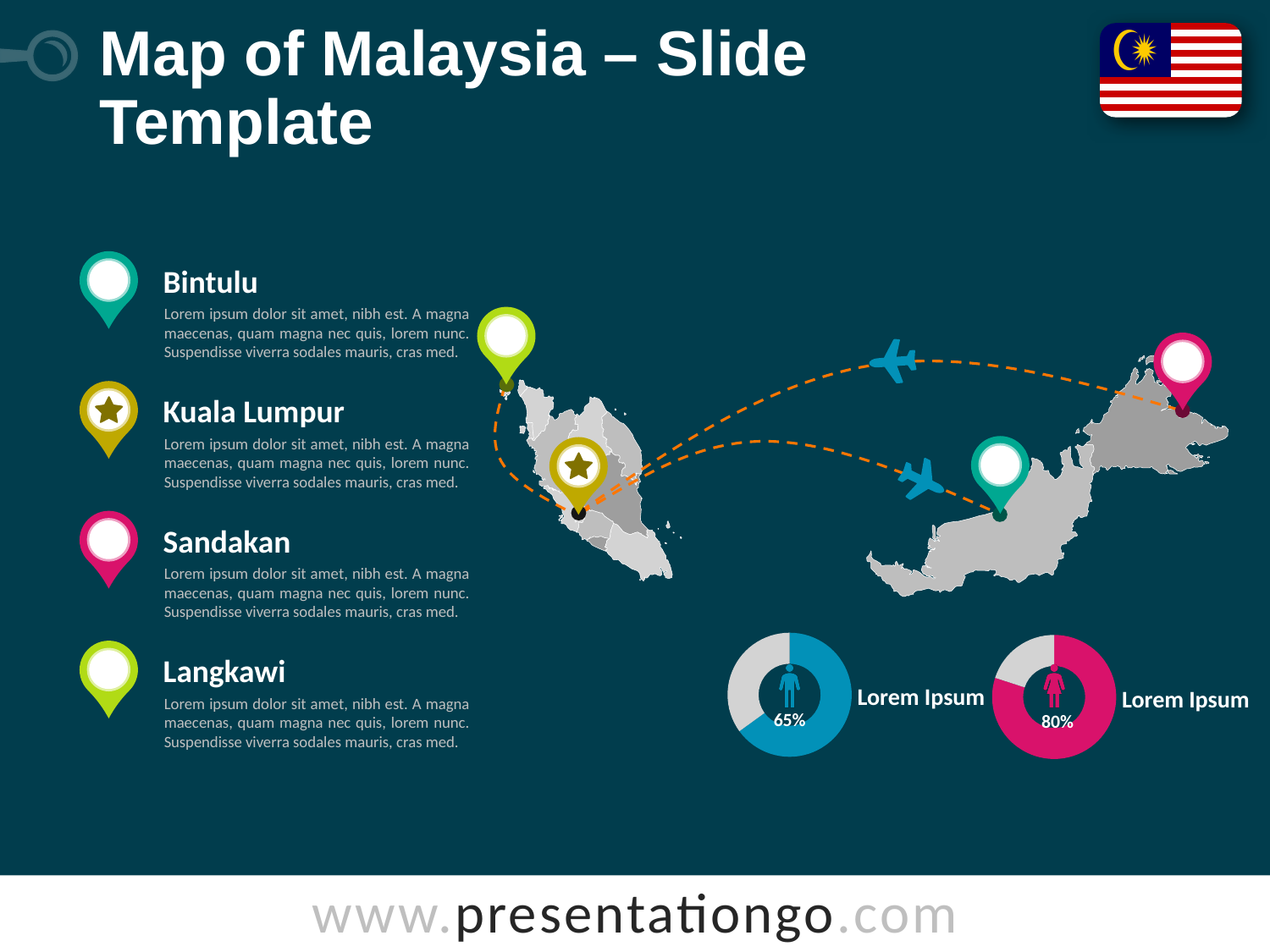
Which donut chart shows the larger percentage, the blue one or the pink one? the pink one What percentage is shown in the centre of the pink donut chart? 80% What share of the pink donut chart is not filled in pink? 20% What colour is the filled portion of the donut chart showing 80%? pink What label text appears to the right of the blue donut chart? Lorem Ipsum What share of the blue donut chart is not filled in blue? 35% Is the value shown on the blue donut chart greater or less than 50%? greater What percentage is shown in the centre of the blue donut chart? 65% What kind of chart is the blue chart at the bottom right of the slide? donut chart What is the difference between the percentage on the pink donut chart and the percentage on the blue donut chart? 15% How many donut charts are on the slide? 2